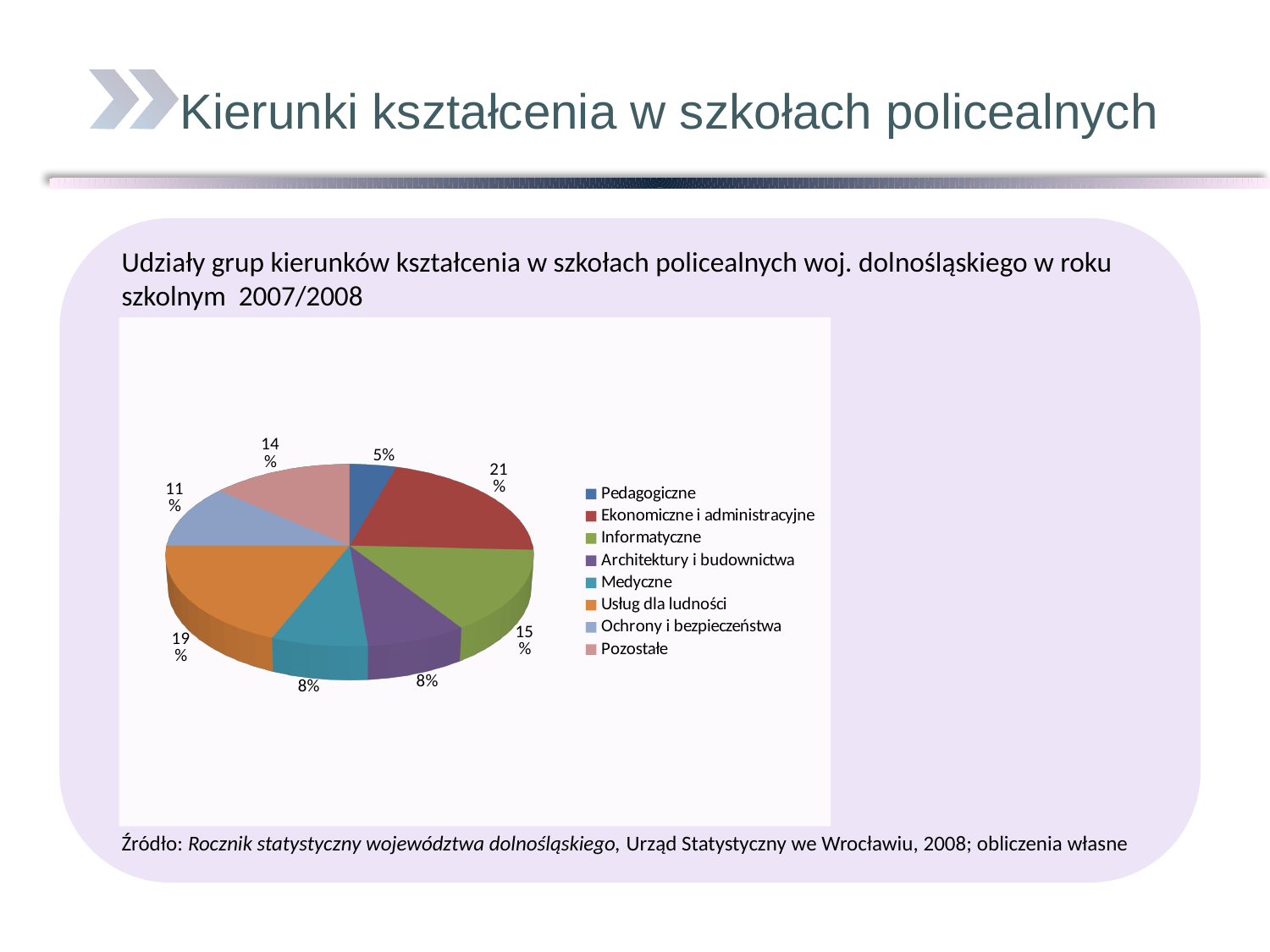
What share of the pie does Pozostałe have? 14% What share of the pie does Ochrony i bezpieczeństwa have? 11% Which has a larger share, Informatyczne or Pozostałe? Informatyczne What share of the pie does Usług dla ludności have? 19% What type of chart is shown on the slide? pie chart What share of the pie does Pedagogiczne have? 5% How many groups are listed in the legend of the pie chart? 8 Which group has the smallest share of the pie? Pedagogiczne What share of the pie does Ekonomiczne i administracyjne have? 21% What is the difference in percentage points between Ekonomiczne i administracyjne and Usług dla ludności? 2 Which group has the largest share of the pie? Ekonomiczne i administracyjne What share of the pie does Informatyczne have? 15%